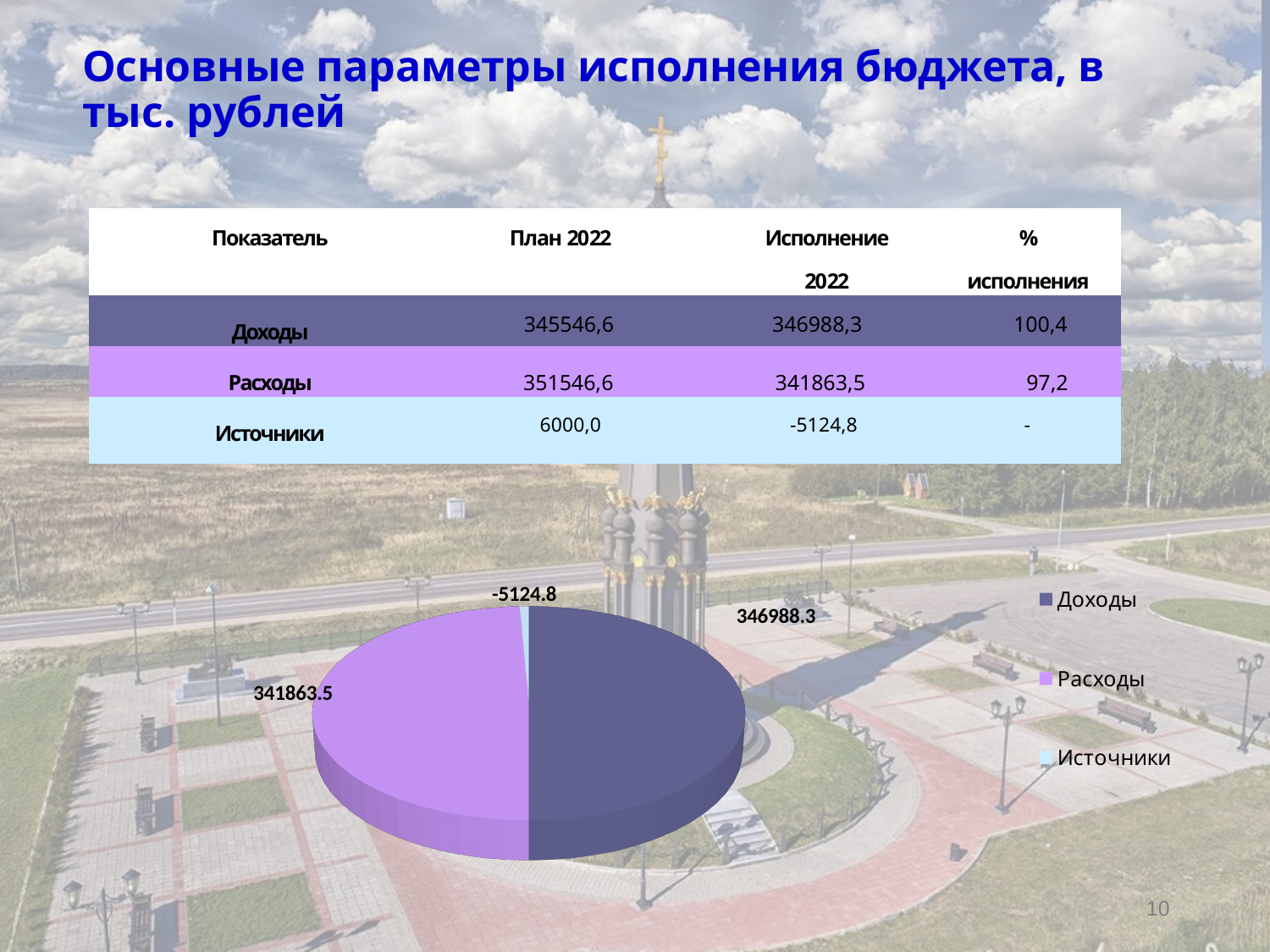
What is the difference between the values for Доходы and Расходы in the pie chart? 5124.8 How many entries does the legend of the pie chart list? 3 Which category has the smallest value in the pie chart? Источники What value is shown for Источники in the pie chart? -5124.8 What colour is the Доходы slice in the pie chart? dark purple How many slices does the pie chart have? 3 Which category has the largest slice in the pie chart? Доходы What value is shown for Расходы in the pie chart? 341863.5 What value is shown for Доходы in the pie chart? 346988.3 What kind of chart is shown on the slide? pie chart Which legend entry is shown in light blue? Источники Which is larger in the pie chart, Доходы or Расходы? Доходы